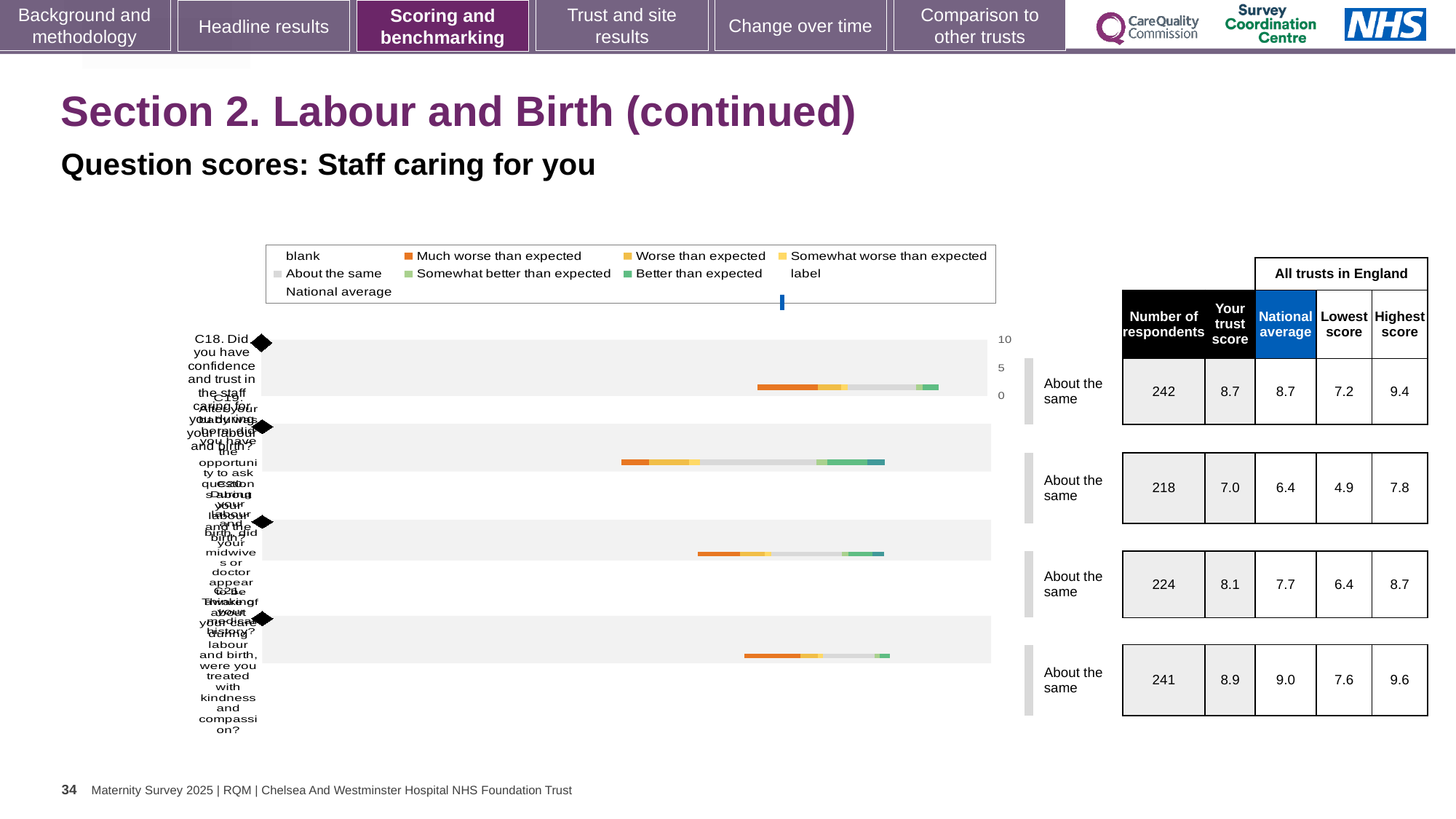
For the third question row, which is larger: the trust score or the national average? the trust score (8.1) What colour does the legend use for 'Much worse than expected'? orange Which table row has the lowest value in the 'Lowest score' column? the second row, 4.9 In the table, what is the national average for the second question row? 6.4 What kind of chart is used to show the question scores on this slide? bar chart Which table row has the highest value in the 'Highest score' column? the fourth (bottom) row, 9.6 What benchmark category is shown next to each of the four questions? About the same For the first question row (C18), what is the difference between the highest score (9.4) and the lowest score (7.2)? 2.2 In the table, what is the number of respondents for the first (top) question, C18? 242 In the table, what is the trust score for the last (bottom) question, C21, about being treated with kindness and compassion? 8.9 In the table, what is the number of respondents for the third question row? 224 How many questions (bars) are plotted in the chart? 4